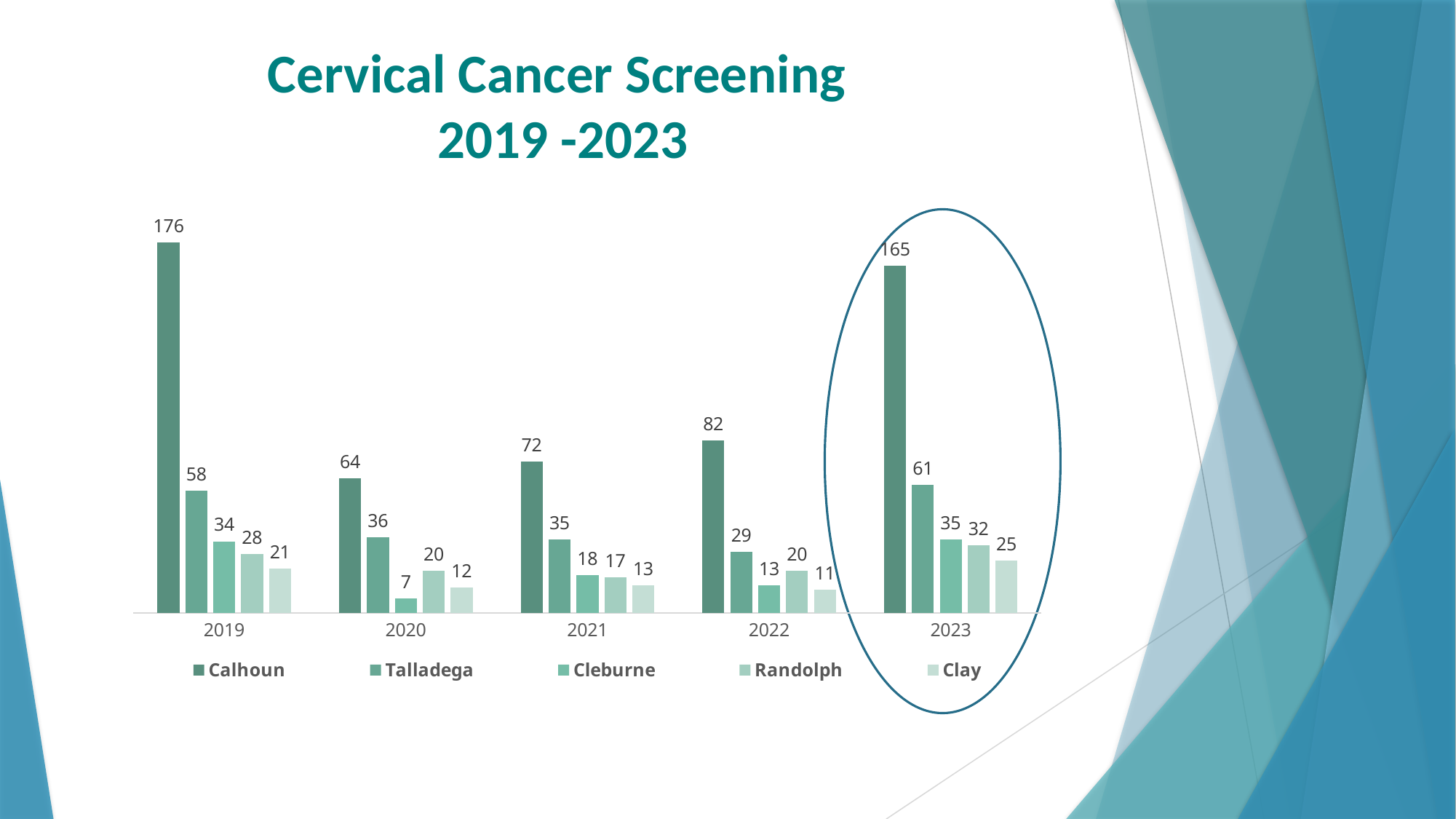
How many years are shown on the x axis? 5 What is the value for Clay in 2023? 25 What kind of chart is shown on the slide? Bar chart What is the title of the chart? Cervical Cancer Screening 2019 -2023 What is the difference between Calhoun's values in 2019 and 2023? 11 What is the value for Cleburne in 2020? 7 How many series does the legend list? 5 Which county has the lowest value in 2021? Clay Does Calhoun's value rise or fall from 2020 to 2023? Rise Which is larger, Talladega in 2023 or Talladega in 2019? Talladega in 2023 What is the value for Calhoun in 2019? 176 Which county has the highest value in 2022? Calhoun